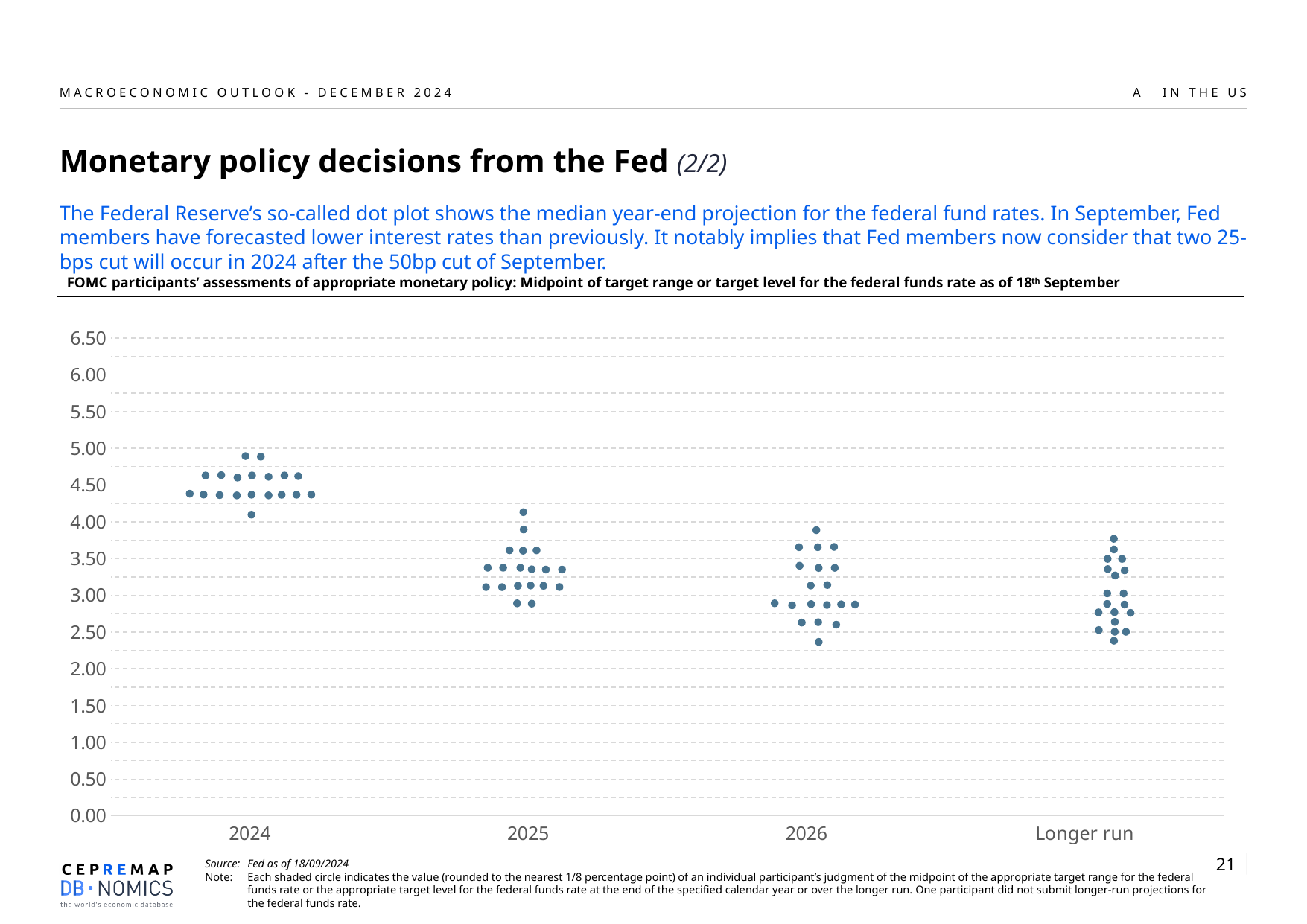
Is the lowest dot for 2024 greater or less than 3.50? greater Is the lowest dot for 2025 greater or less than 2.50? greater Do the projected rates generally rise or fall from 2024 to 2026? Fall What kind of chart is shown on the slide? Dot plot (scatter chart) How many categories are shown on the x axis of the chart? 4 Is the highest dot for Longer run greater or less than 4.00? less What is the label of the last category on the x axis? Longer run Are the dots for 2024 higher or lower than the dots for 2025? Higher What is the highest value shown on the y axis of the chart? 6.50 Which category on the x axis has the highest dots? 2024